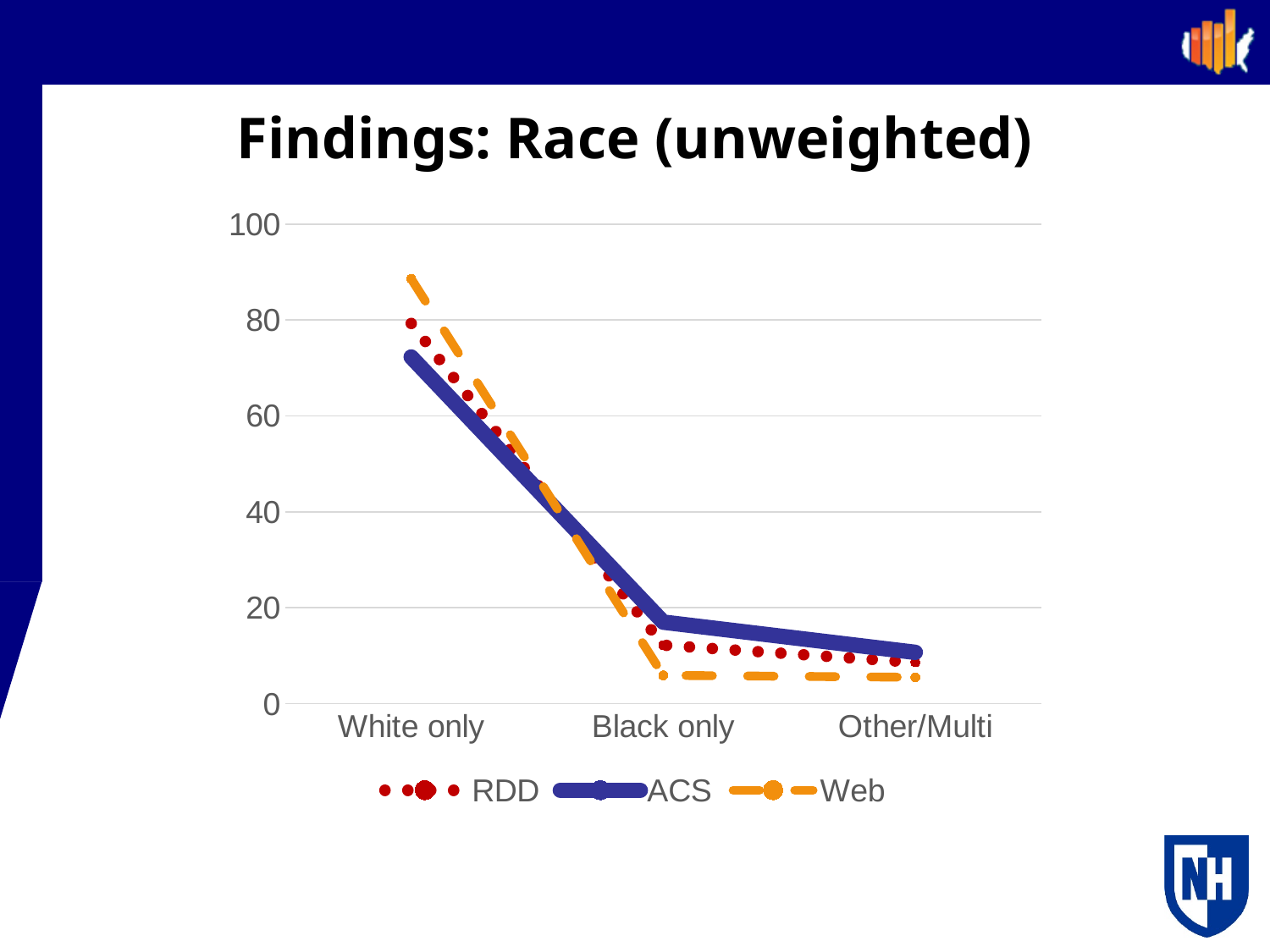
Do the values for the ACS series rise or fall from White only to Other/Multi? fall What is the title of the chart? Findings: Race (unweighted) Which series has the highest value at White only? Web Which series are listed in the legend? RDD, ACS, Web Which category has the highest value for the RDD series? White only Is the value for Web at Black only greater or less than 20? less How many categories are shown on the x axis? 3 At Black only, which is larger, the ACS value or the Web value? ACS How many series does the legend list? 3 Is the value for ACS at White only greater or less than 80? less Is the value for Web at White only greater or less than 80? greater What kind of chart is shown on the slide? line chart